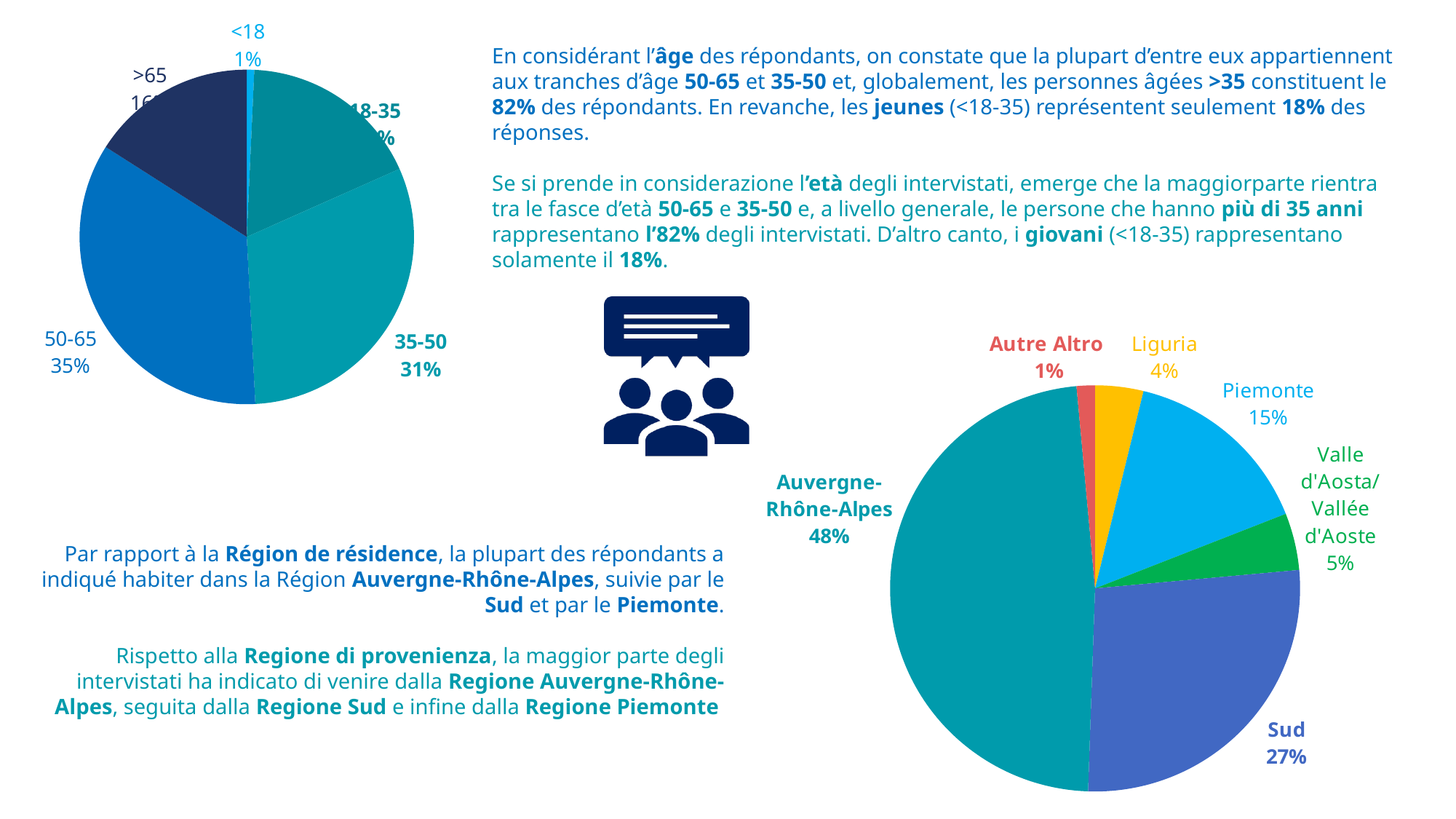
In the region pie chart on the right, what is the difference in percentage points between Auvergne-Rhône-Alpes and Sud? 21 percentage points In the age pie chart on the left, what share of respondents are under 18? 1% In the age pie chart on the left, what share of respondents are aged 35-50? 31% In the region pie chart on the right, what share of respondents live in Auvergne-Rhône-Alpes? 48% In the region pie chart on the right, which region has the smallest share? Autre Altro In the age pie chart on the left, which age group has the largest share? 50-65 In the region pie chart on the right, what share of respondents live in Sud? 27% In the region pie chart on the right, what share of respondents live in Piemonte? 15% What type of chart is used on the right to show the region of residence? Pie chart In the age pie chart on the left, which age group has the smallest share? <18 In the age pie chart on the left, how many age groups are shown? 5 In the age pie chart on the left, what share of respondents are aged 50-65? 35%